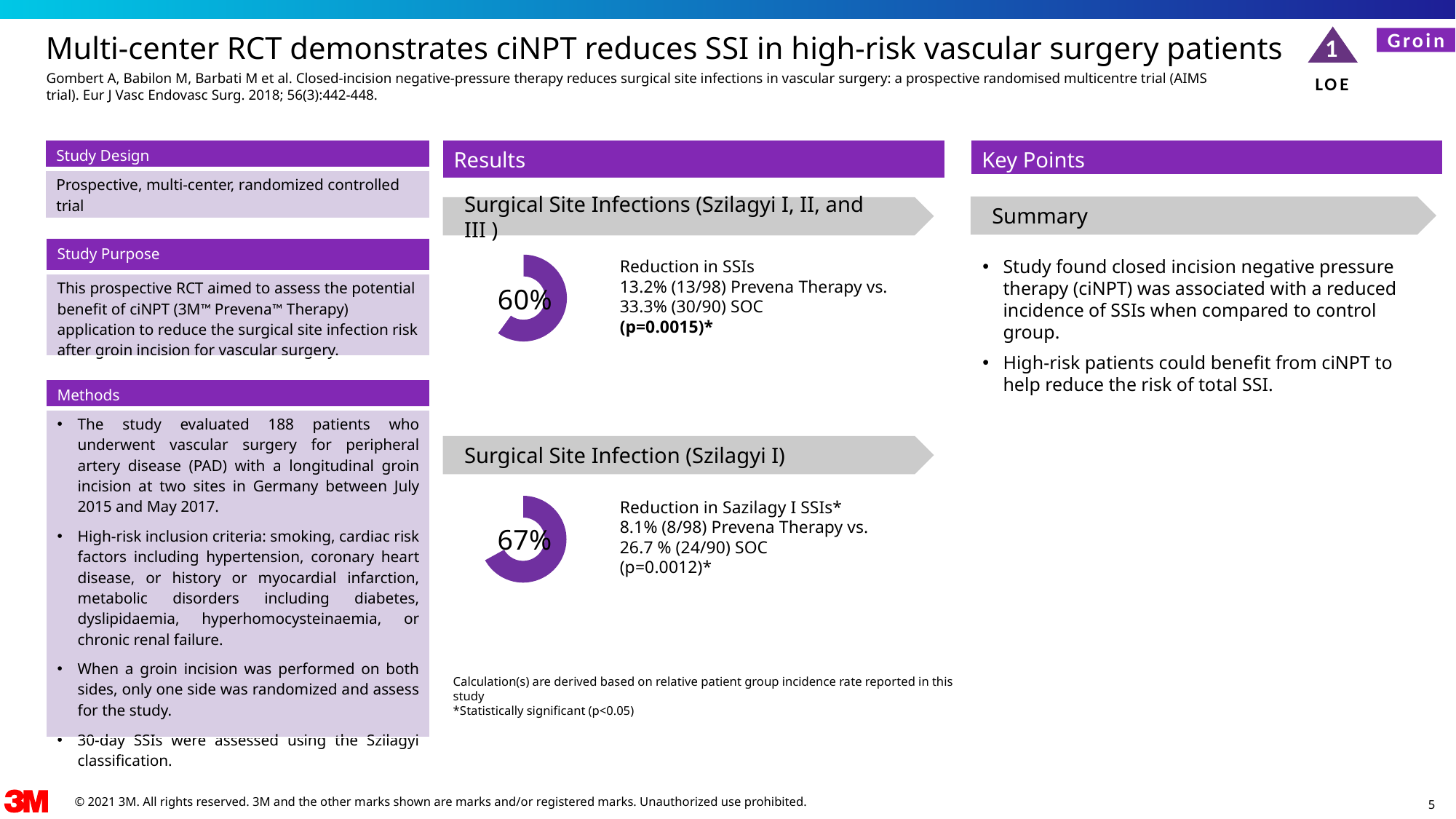
Is the value shown in the Szilagyi I donut chart greater or less than 75%? less What share of the Szilagyi I, II, and III donut chart is filled in purple? 60% How many donut charts are shown in the Results section of the slide? 2 In the donut chart under "Surgical Site Infection (Szilagyi I)", what percentage is shown in the centre? 67% What colour is the filled portion of the donut charts on the slide? Purple What kind of chart is used to show the 67% reduction in Szilagyi I SSIs? Donut (pie) chart What is the difference between the percentage in the Szilagyi I donut chart and the percentage in the Szilagyi I, II, and III donut chart? 7 percentage points What kind of chart is used to show the 60% reduction in SSIs? Donut (pie) chart What share of the Szilagyi I donut chart is filled in purple? 67% Which donut chart shows the larger percentage: the Szilagyi I, II, and III chart or the Szilagyi I chart? Szilagyi I chart (67%) Is the value shown in the Szilagyi I, II, and III donut chart greater or less than 50%? greater In the donut chart under "Surgical Site Infections (Szilagyi I, II, and III )", what percentage is shown in the centre? 60%